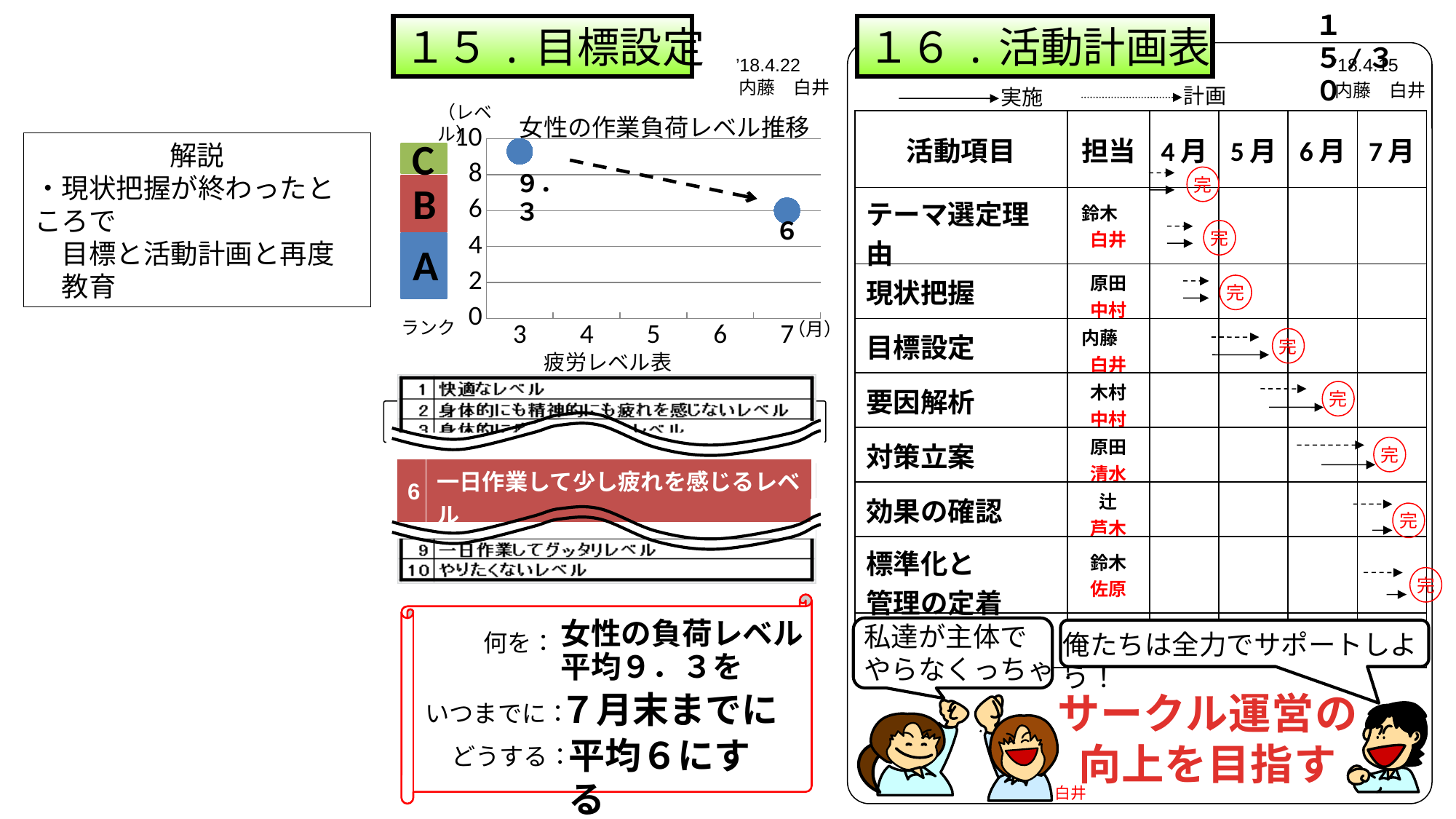
In the chart 女性の作業負荷レベル推移, what is the value plotted for month 7? 6 In the chart 女性の作業負荷レベル推移, what is the difference between the value at month 3 and the value at month 7? 3.3 In the chart 女性の作業負荷レベル推移, is the value for month 7 greater or less than 4? greater What is the maximum value shown on the vertical axis of the chart 女性の作業負荷レベル推移? 10 How many data points are plotted in the chart 女性の作業負荷レベル推移? 2 What is the title of the chart on the left half of the slide? 女性の作業負荷レベル推移 In the chart 女性の作業負荷レベル推移, is the value for month 3 greater or less than 8? greater In the chart 女性の作業負荷レベル推移, at which month is the lowest value plotted? Month 7 In the chart 女性の作業負荷レベル推移, what is the value plotted for month 3? 9.3 In the chart 女性の作業負荷レベル推移, at which month is the highest value plotted? Month 3 In the chart 女性の作業負荷レベル推移, which month has the larger value, month 3 or month 7? Month 3 In the chart 女性の作業負荷レベル推移, do the values rise or fall from month 3 to month 7? Fall